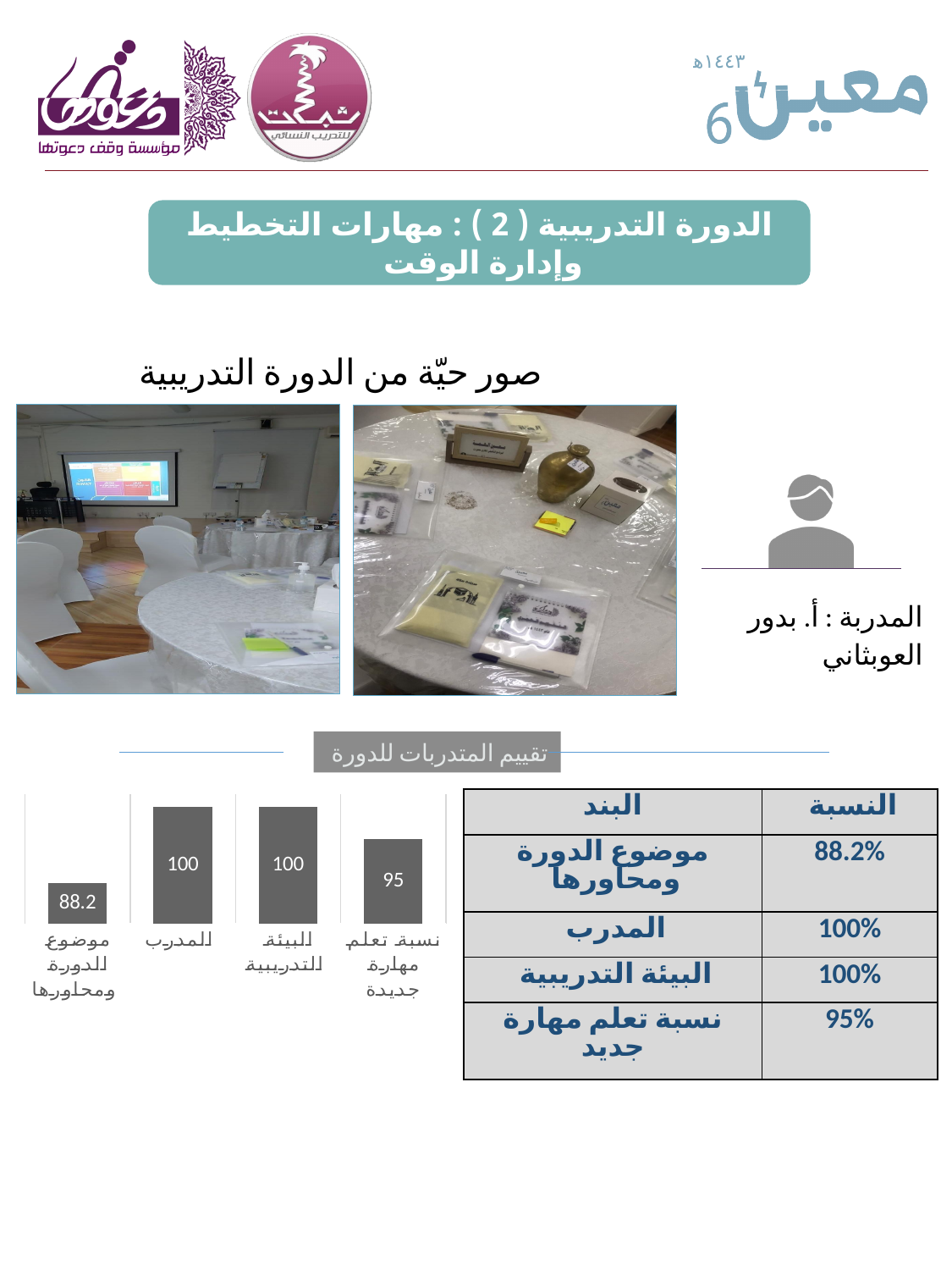
What is the difference between the value for "المدرب" and the value for "موضوع الدورة ومحاورها" in the bar chart? 11.8 What is the difference between the value for "البيئة التدريبية" and the value for "نسبة تعلم مهارة جديدة" in the bar chart? 5 What is the value shown for "البيئة التدريبية" in the bar chart? 100 Which two categories in the bar chart share the highest value of 100? المدرب and البيئة التدريبية How many categories (bars) does the bar chart show? 4 What is the value shown for "موضوع الدورة ومحاورها" in the bar chart? 88.2 In the bar chart, which is larger: the value for "نسبة تعلم مهارة جديدة" or the value for "موضوع الدورة ومحاورها"? نسبة تعلم مهارة جديدة What is the value shown for "المدرب" in the bar chart? 100 Which category has the lowest value in the bar chart? موضوع الدورة ومحاورها What is the value shown for "نسبة تعلم مهارة جديدة" in the bar chart? 95 What colour are the bars in the bar chart? grey What kind of chart is shown at the bottom of the slide under "تقييم المتدربات للدورة"? bar chart